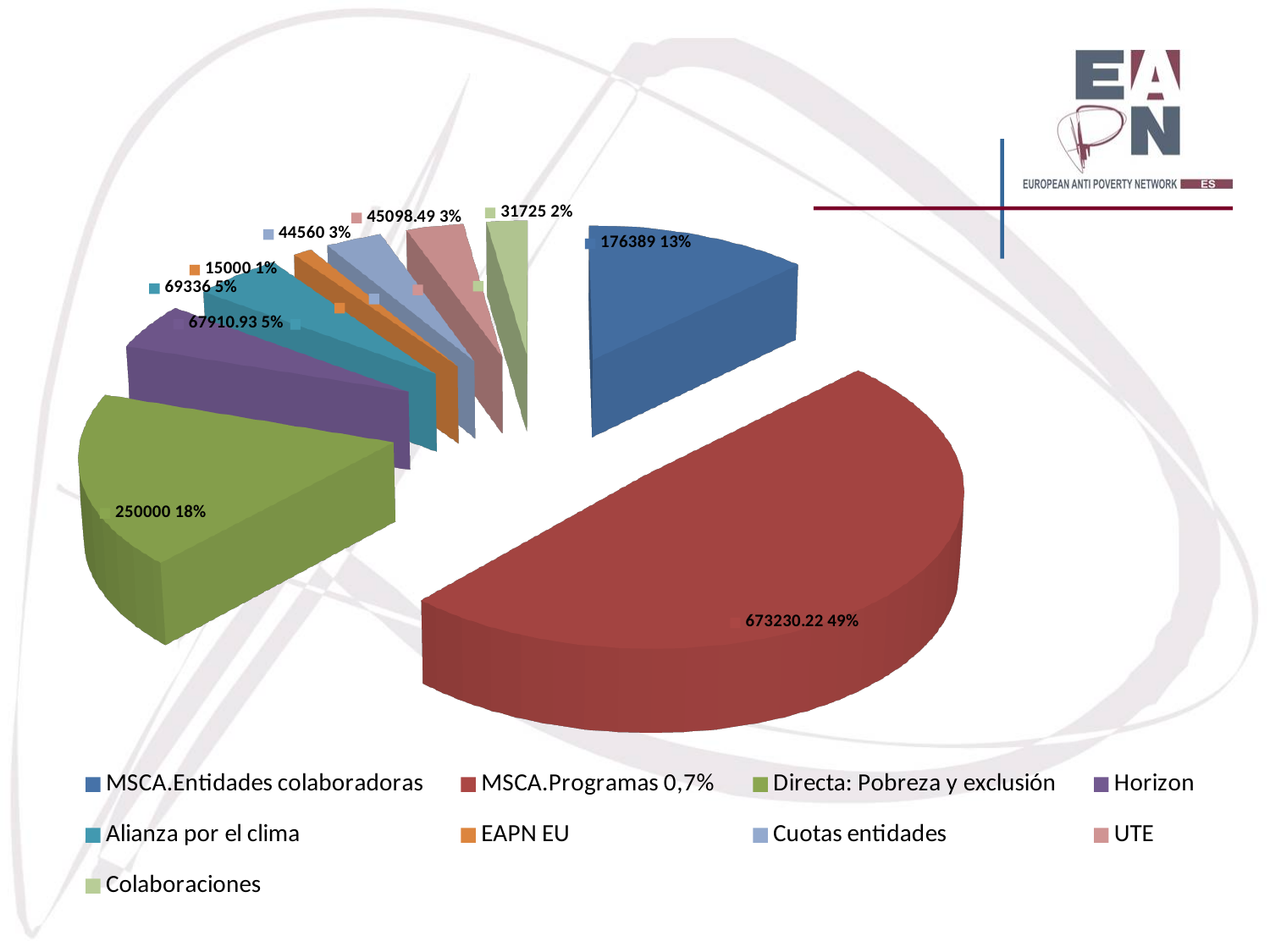
What is the difference between the values for Directa: Pobreza y exclusión and MSCA.Entidades colaboradoras? 73611 Which category has the smallest slice of the pie? EAPN EU Which is larger, the value for Cuotas entidades or the value for UTE? UTE What percentage share does Colaboraciones have? 2% How many slices does the pie chart have? 9 What value is shown for MSCA.Entidades colaboradoras? 176389 What value is shown for EAPN EU? 15000 What kind of chart is shown on the slide? pie chart Which category has the largest slice of the pie? MSCA.Programas 0,7% What percentage share does Directa: Pobreza y exclusión have? 18% What value is shown for MSCA.Programas 0,7%? 673230.22 What colour is the slice for Horizon? purple